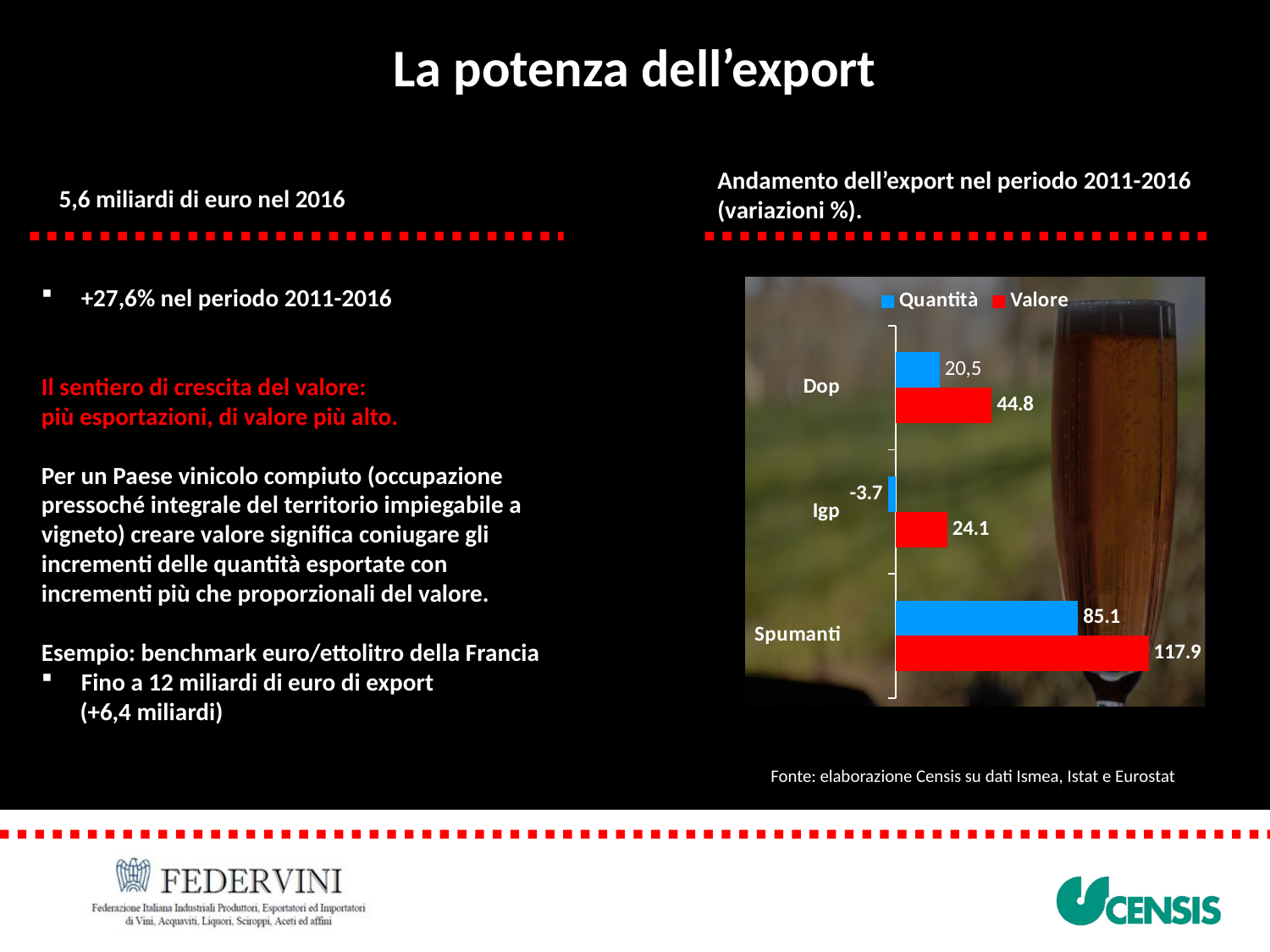
Which category has the highest Valore value? Spumanti What is the Valore value for Spumanti? 117.9 What is the Valore value for Dop? 44.8 Which colour represents the Valore series in the chart? red What type of chart is shown on the slide? bar chart What is the Quantità value for Spumanti? 85.1 What is the difference between the Valore and Quantità values for Spumanti? 32.8 Which is larger for Igp, the Quantità value or the Valore value? Valore How many series does the chart legend list? 2 What is the Quantità value for Igp? -3.7 Which category has the lowest Quantità value? Igp How many categories are shown on the chart? 3